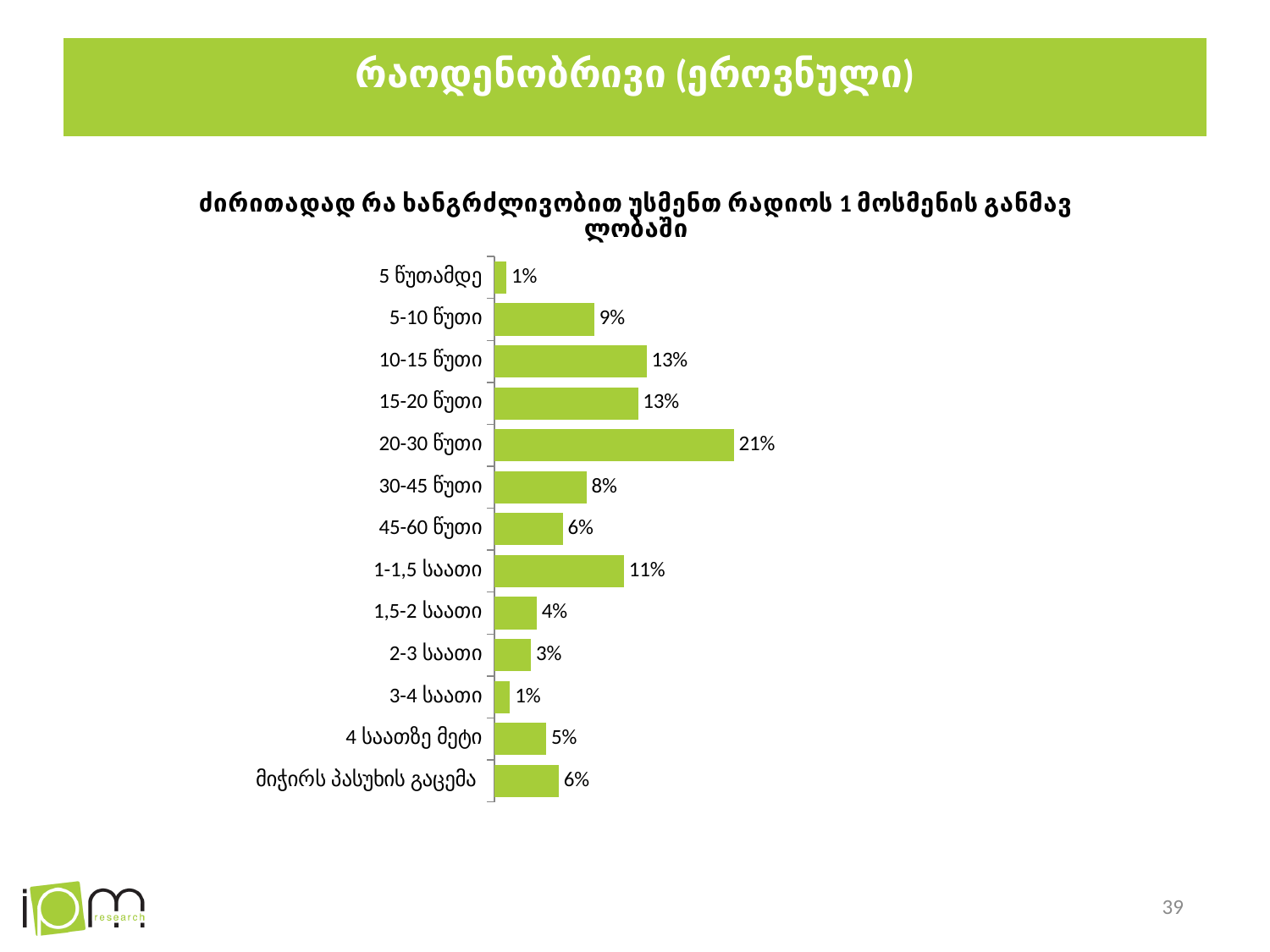
What is the value for 15-20 წუთი? 13% What is the value for 5-10 წუთი? 9% Which category has the highest value? 20-30 წუთი What is the value for 1-1,5 საათი? 11% What is the value for მიჭირს პასუხის გაცემა? 6% Which is larger, the value for 1-1,5 საათი or the value for 30-45 წუთი? 1-1,5 საათი Which is larger, the value for 1,5-2 საათი or the value for 2-3 საათი? 1,5-2 საათი What is the value for 4 საათზე მეტი? 5% What kind of chart is shown on the slide? bar chart How many categories are shown in the chart? 13 What is the value for 20-30 წუთი? 21% What is the difference between the values for 20-30 წუთი and 5-10 წუთი? 12%